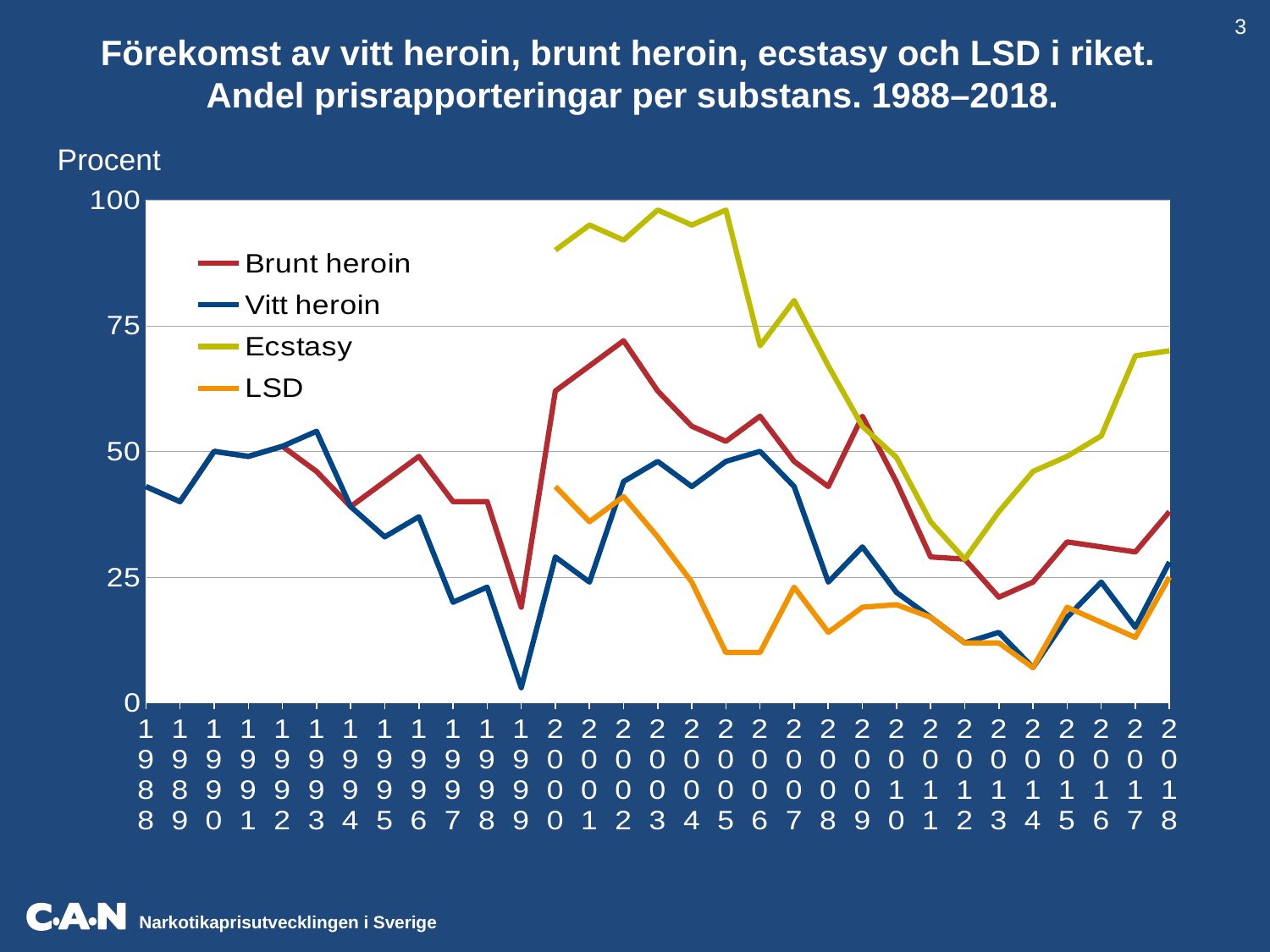
Does the Ecstasy line rise or fall between 2005 and 2012? fall Is the value for Brunt heroin in 2002 greater or less than 50? greater How many years are plotted along the x axis? 31 Is the value for Vitt heroin in 1999 greater or less than 25? less How many series does the legend list? 4 Is the value for Ecstasy in 2005 greater or less than 75? greater What label is shown on the vertical axis? Procent What kind of chart is shown on the slide? line chart In 2000, which is larger: Ecstasy or Brunt heroin? Ecstasy Which series has the highest value in 2005? Ecstasy In 2008, which is larger: Brunt heroin or Vitt heroin? Brunt heroin